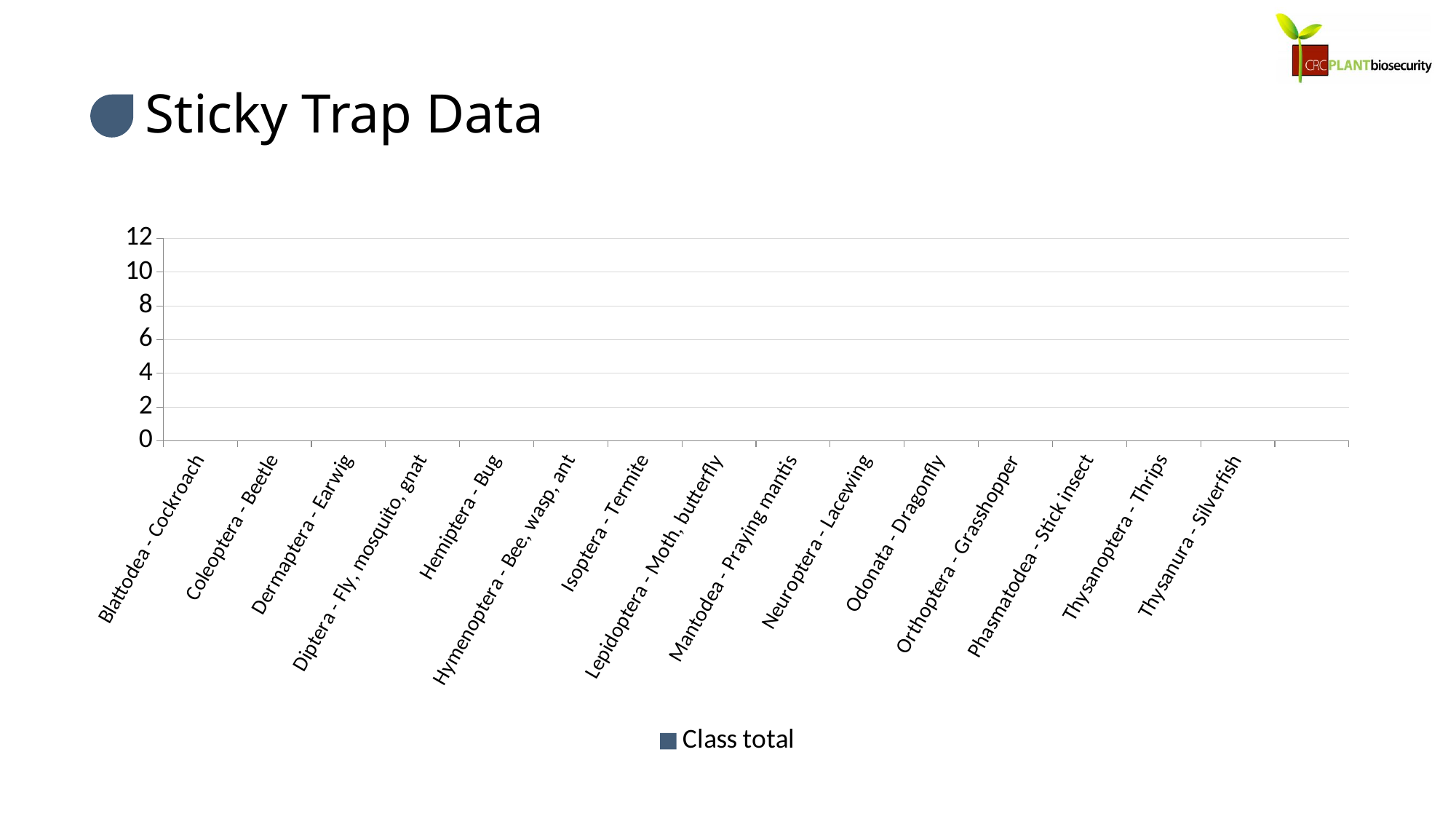
What is the title shown above the chart on the slide? Sticky Trap Data What is the last category listed on the x axis of the chart? Thysanura - Silverfish Are any bars visible above the x axis in the chart? No What is the highest value shown on the chart's y axis? 12 What is the lowest value shown on the chart's y axis? 0 How many series does the chart's legend list? 1 How many categories are labelled on the x axis of the chart? 15 What is the name of the series shown in the chart's legend? Class total What is the first category listed on the x axis of the chart? Blattodea - Cockroach